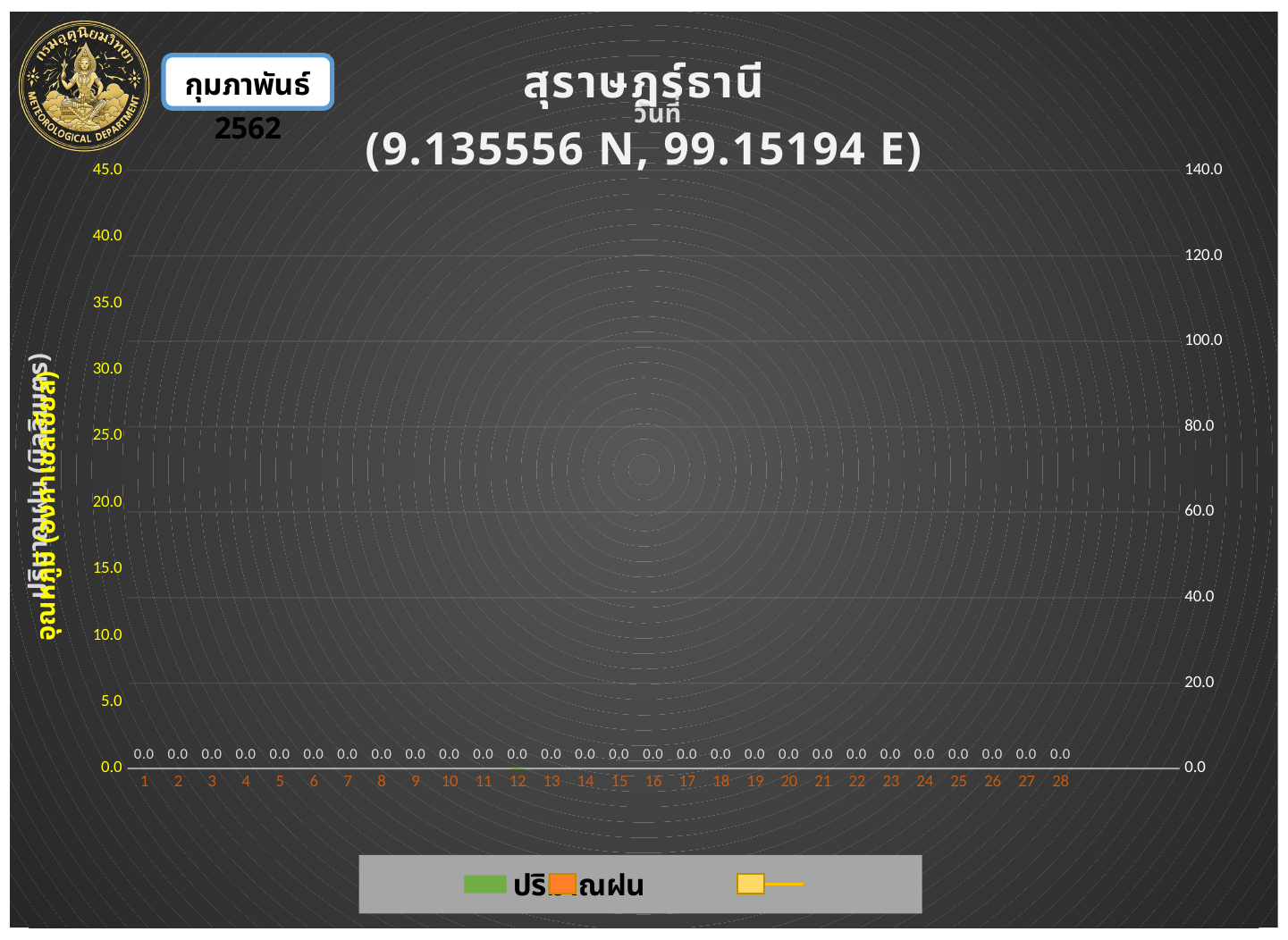
How many days (categories) are shown along the x axis of the chart? 28 What is the highest tick value shown on the left vertical axis? 45.0 What value is printed above day 15 on the chart? 0.0 What is the highest tick value shown on the right vertical axis? 140.0 Is the value for day 20 greater or less than 20.0 on the right axis? less What is the data label shown for day 1 on the chart? 0.0 What is the value shown for day 28? 0.0 What is the difference between the values printed for day 3 and day 10? 0.0 Is the value for day 5 greater or less than 5.0 on the left axis? less Do the printed values rise, fall, or stay flat from day 1 to day 28? stay flat